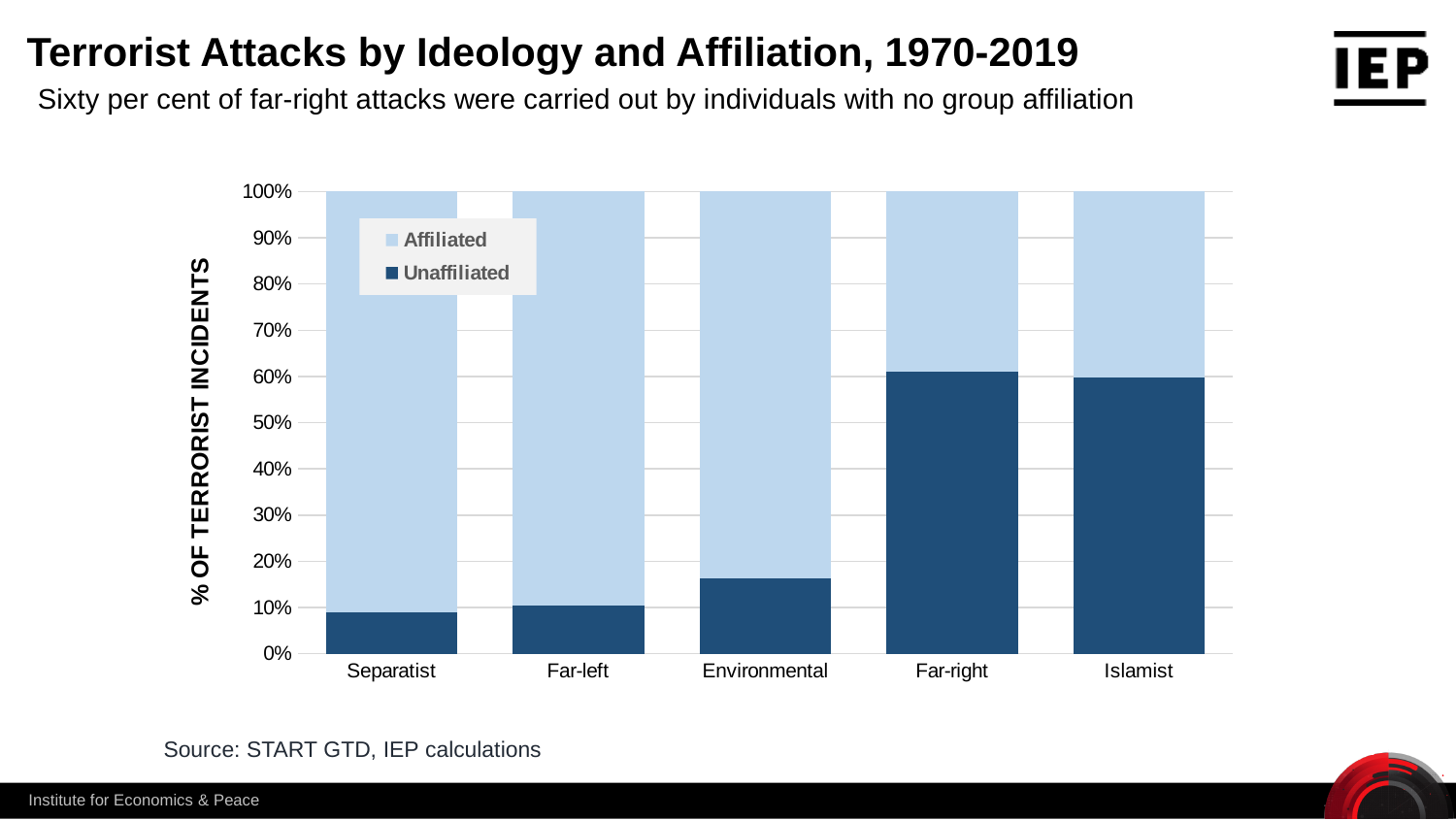
What kind of chart is shown on the slide? Stacked bar chart What is the label on the y axis? % OF TERRORIST INCIDENTS Is the Unaffiliated value for Far-right greater or less than 50%? greater Is the Unaffiliated value for Environmental greater or less than 20%? less How many series does the legend list? 2 Is the Unaffiliated value for Environmental greater or less than 10%? greater What is the total height of the Separatist stacked bar? 100% How many ideology categories are shown on the x axis? 5 Which has a larger Affiliated share, Far-left or Islamist? Far-left Which has a larger Unaffiliated share, Environmental or Far-right? Far-right